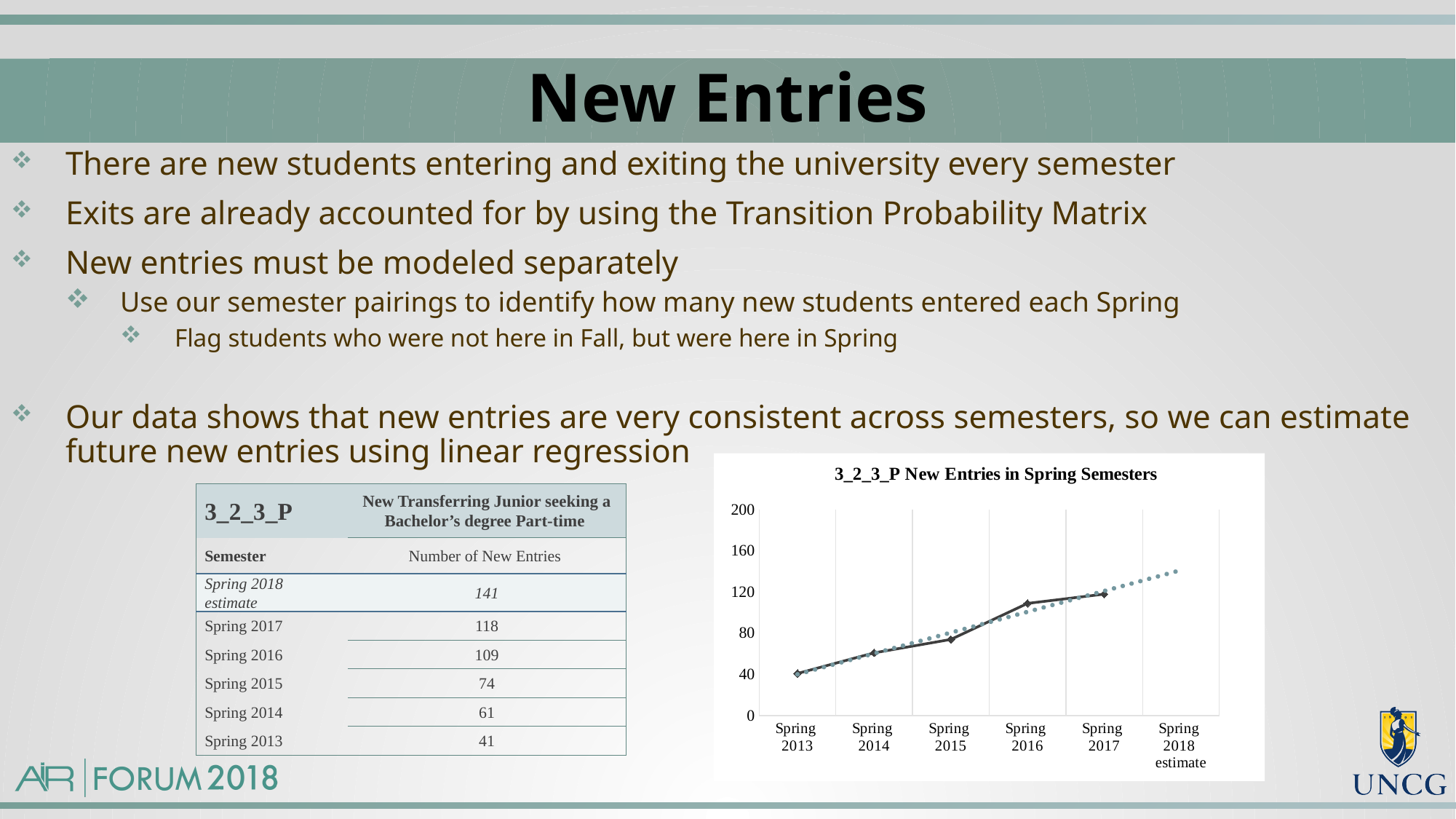
What kind of chart is shown on the slide? line chart Which plotted semester has the highest number of new entries on the solid line? Spring 2017 What is the difference between the Spring 2017 and Spring 2013 new entries shown on the slide? 77 Is the value for Spring 2016 greater or less than 80? greater Is the value for Spring 2014 greater or less than 80? less Which semester has the lowest number of new entries in the chart? Spring 2013 Which is larger, the number of new entries in Spring 2015 or Spring 2016? Spring 2016 What is the title of the chart? 3_2_3_P New Entries in Spring Semesters Is the value for Spring 2017 greater or less than 160? less According to the slide, how many new entries were there in Spring 2017? 118 How many semesters are plotted along the x axis of the chart? 6 Do the new entries rise or fall from Spring 2013 to Spring 2017? rise